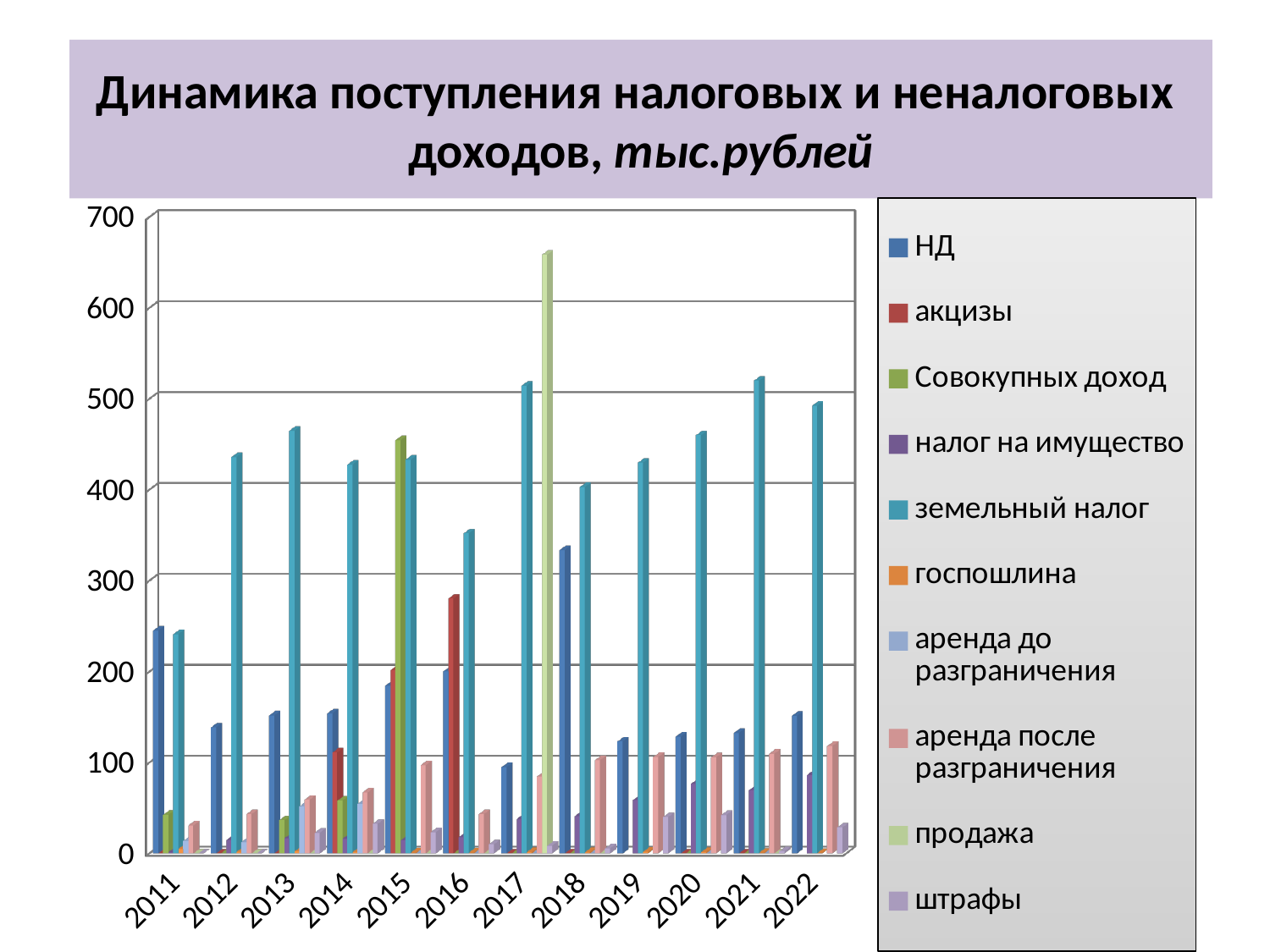
In which year is the value for НД the highest? 2018 How many years are shown on the x axis of the chart? 12 Is the value for продажа in 2017 greater or less than 600? greater Which series is shown in orange in the legend? госпошлина Is the value for акцизы in 2016 greater or less than 300? less What is the title of the chart? Динамика поступления налоговых и неналоговых доходов, тыс.рублей How many series does the legend list? 10 Which is larger: земельный налог in 2012 or земельный налог in 2016? 2012 What kind of chart is shown on the slide? bar chart Is the value for земельный налог in 2021 greater or less than 500? greater Does the value for земельный налог rise or fall from 2017 to 2018? fall